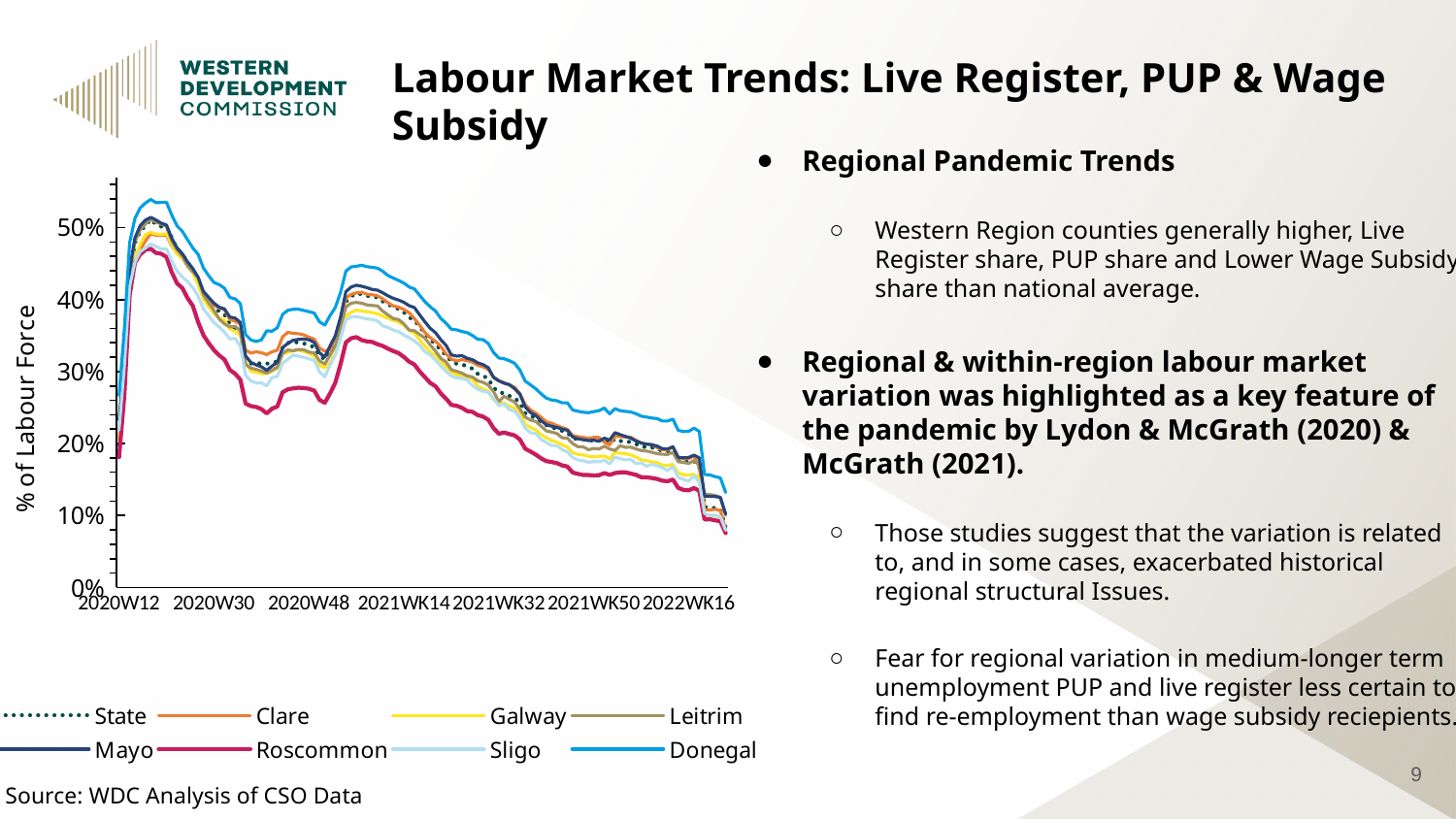
What is the label of the vertical axis? % of Labour Force Overall, do the values rise or fall from 2021WK14 to 2022WK16? fall Is the value for Roscommon at the end of the series (2022) greater or less than 10%? less Is the peak value for Roscommon in 2020 greater or less than 50%? less Which series is drawn as a dotted line in the legend? State Which series is generally the lowest line on the chart? Roscommon What kind of chart is shown on the slide? line chart How many tick labels are shown on the x axis? 7 Which line is higher around 2020W48, Donegal or Roscommon? Donegal Is the peak value for Donegal in 2020 greater or less than 50%? greater Which series is generally the highest line on the chart? Donegal How many series does the chart's legend list? 8